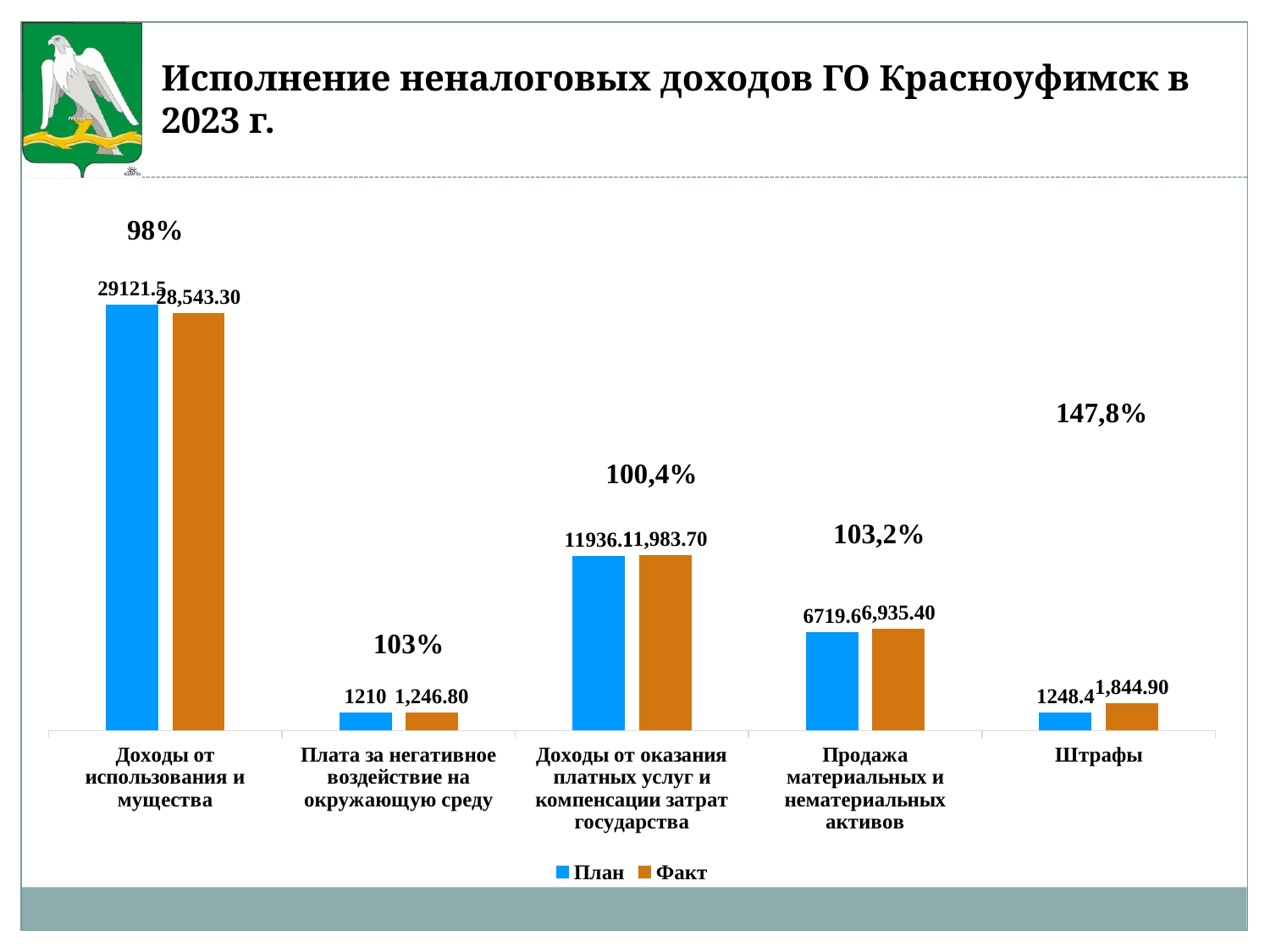
Which category has the highest Факт value? Доходы от использования имущества How many categories are shown on the x axis? 5 What type of chart is shown on the slide? bar chart What is the Факт value for Штрафы? 1,844.90 What is the План value for Плата за негативное воздействие на окружающую среду? 1210 Which is larger for Доходы от использования имущества: the План value or the Факт value? План Which category has the lowest План value? Плата за негативное воздействие на окружающую среду What is the difference between the Факт and План values for Штрафы? 596.5 What is the Факт value for Продажа материальных и нематериальных активов? 6,935.40 What percentage is shown above the bars for Штрафы? 147,8% What is the План value for Штрафы? 1248.4 How many series does the legend list? 2